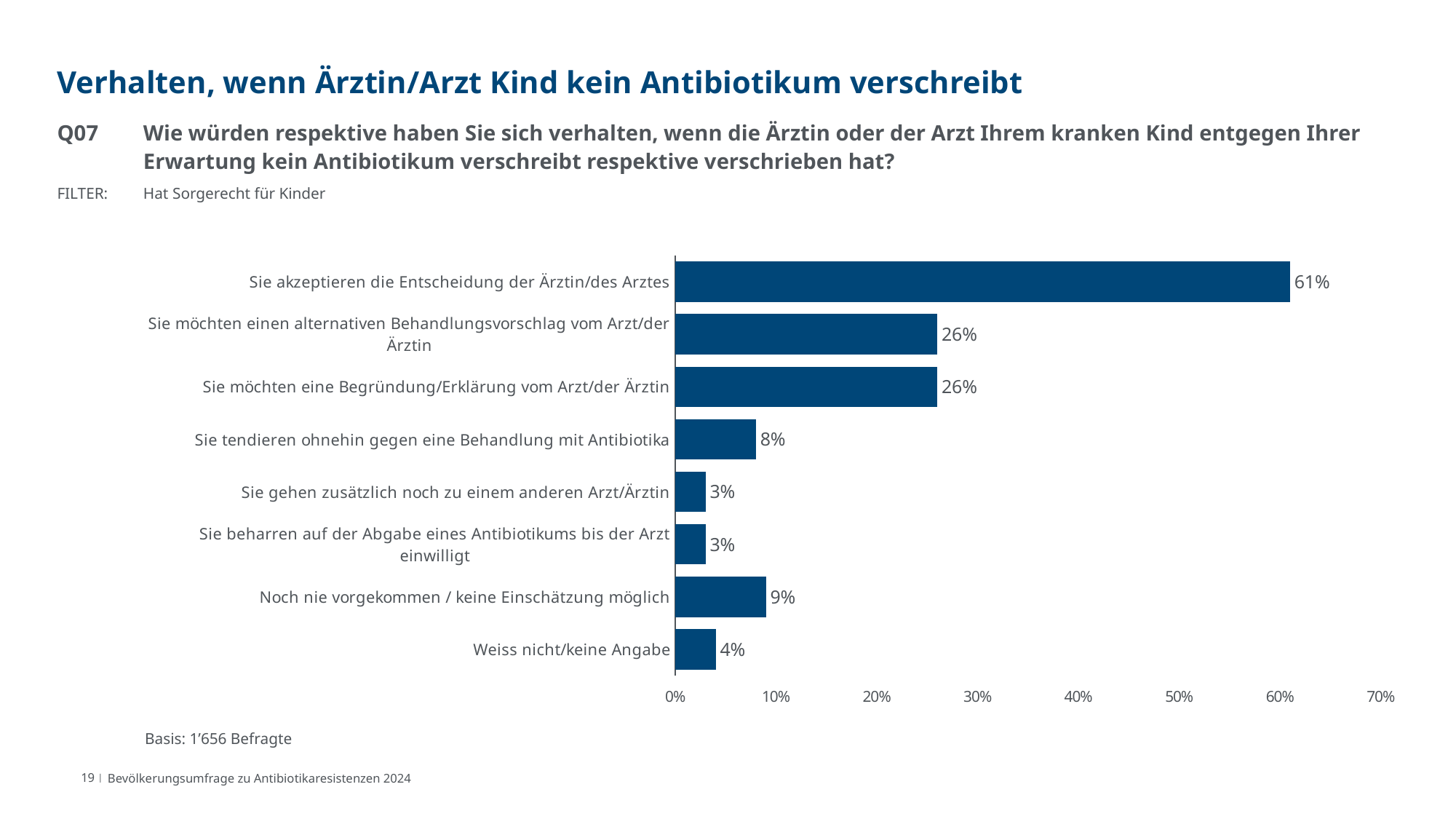
What is the value for "Sie tendieren ohnehin gegen eine Behandlung mit Antibiotika"? 8% Which is larger: the value for "Sie tendieren ohnehin gegen eine Behandlung mit Antibiotika" or the value for "Noch nie vorgekommen / keine Einschätzung möglich"? Noch nie vorgekommen / keine Einschätzung möglich What is the value for "Weiss nicht/keine Angabe"? 4% What is the difference between the value for "Noch nie vorgekommen / keine Einschätzung möglich" and the value for "Weiss nicht/keine Angabe"? 5% What is the value for "Sie akzeptieren die Entscheidung der Ärztin/des Arztes"? 61% What kind of chart is shown on the slide? Bar chart What is the basis (number of respondents) stated below the chart? 1'656 Befragte What is the value for "Noch nie vorgekommen / keine Einschätzung möglich"? 9% Which category has the highest value? Sie akzeptieren die Entscheidung der Ärztin/des Arztes Is the value for "Sie akzeptieren die Entscheidung der Ärztin/des Arztes" greater or less than 50%? greater What is the difference between the value for "Sie akzeptieren die Entscheidung der Ärztin/des Arztes" and the value for "Sie möchten eine Begründung/Erklärung vom Arzt/der Ärztin"? 35% How many categories are shown in the chart? 8